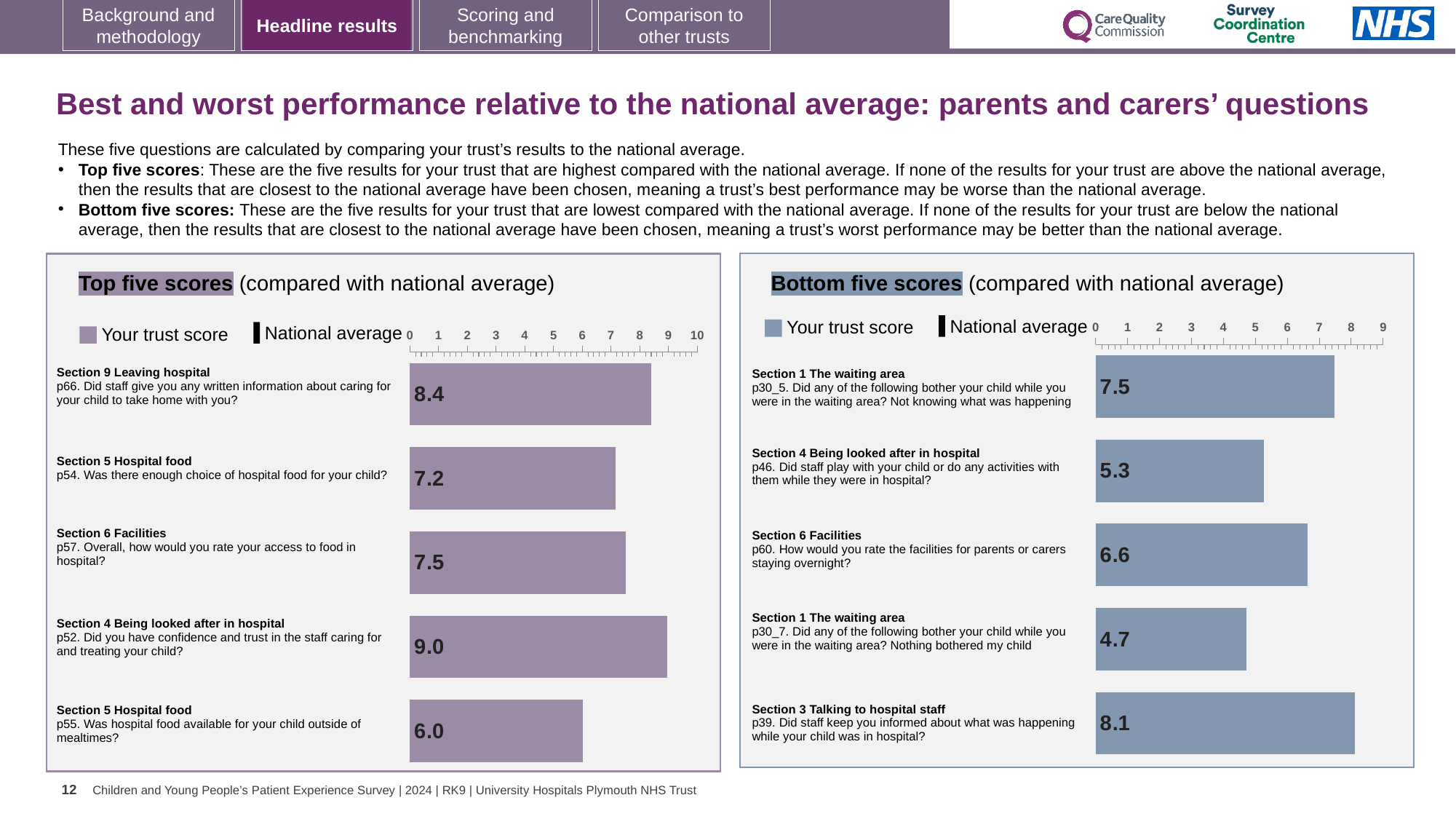
In the Bottom five scores chart, what is the trust score for p46 (staff playing with your child or doing activities)? 5.3 In the Top five scores chart, which question has the highest trust score? p52. Did you have confidence and trust in the staff caring for and treating your child? What type of chart is the Bottom five scores chart? Bar chart In the Bottom five scores chart, which has the larger trust score: p60 (facilities for parents or carers staying overnight) or p30_7 (nothing bothered my child)? p60 In the Top five scores chart, what is the difference between the trust scores for p52 and p55? 3.0 In the Top five scores chart, what is the trust score for p52 (confidence and trust in the staff caring for and treating your child)? 9.0 How many questions are shown in the Top five scores chart? 5 In the Bottom five scores chart, what is the trust score for p39 (staff keeping you informed about what was happening)? 8.1 In the Top five scores chart, what is the trust score for p66 (written information about caring for your child to take home)? 8.4 In the Bottom five scores chart, what is the difference between the trust scores for p30_5 and p46? 2.2 In the Bottom five scores chart, which question has the lowest trust score? p30_7. Did any of the following bother your child while you were in the waiting area? Nothing bothered my child How many series does the legend of the Top five scores chart list? 2